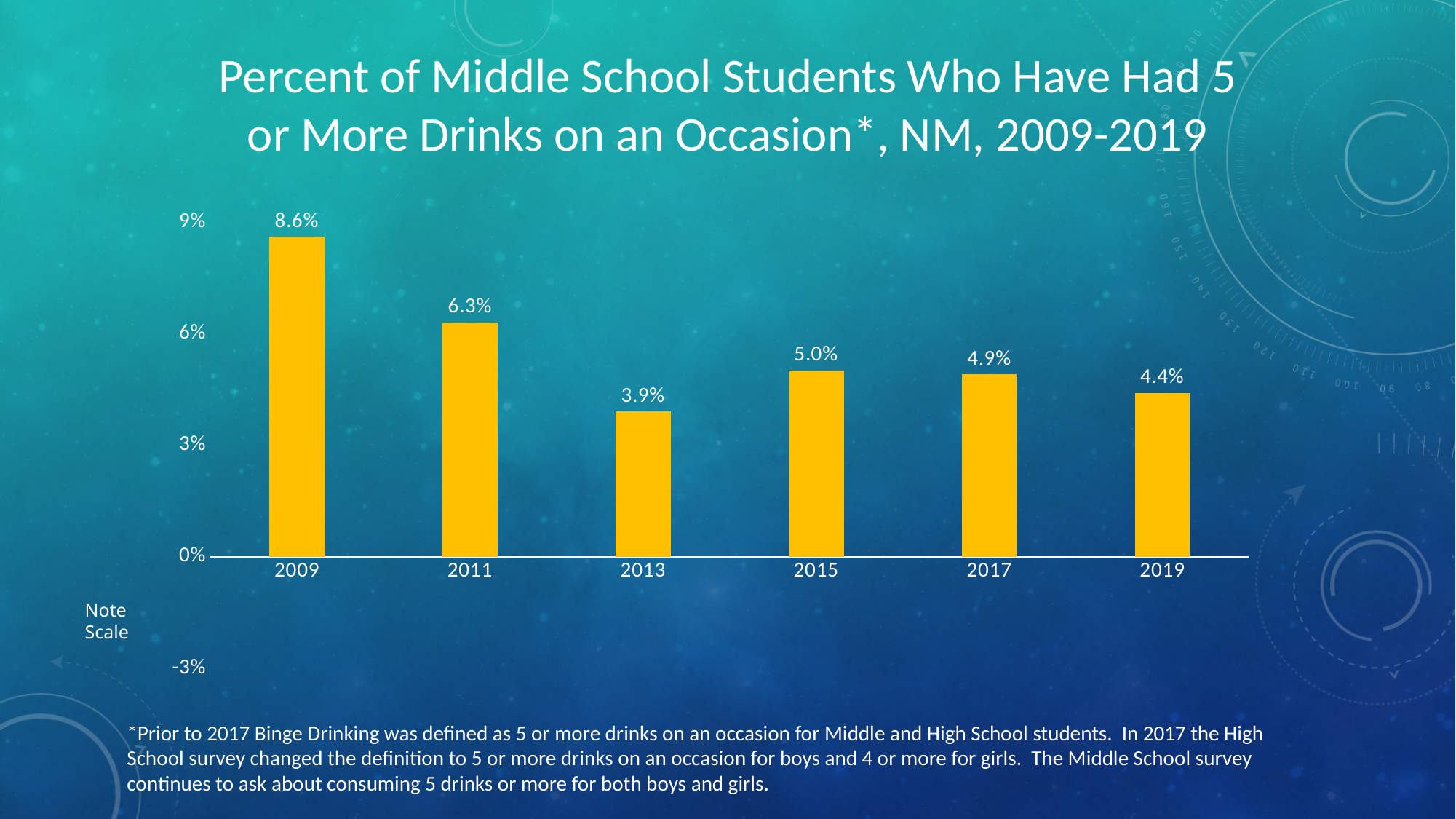
What is the difference between the values for 2011 and 2013? 2.4% Is the value for 2011 greater or less than 6%? greater How many years are shown on the x axis? 6 What is the value for 2019? 4.4% Which is larger, the value for 2015 or the value for 2019? 2015 What is the value for 2013? 3.9% Which year has the highest value? 2009 Which year has the lowest value? 2013 What is the value for 2009? 8.6% What is the difference between the values for 2009 and 2019? 4.2% Do the values generally rise or fall from 2009 to 2013? fall What kind of chart is shown on the slide? bar chart